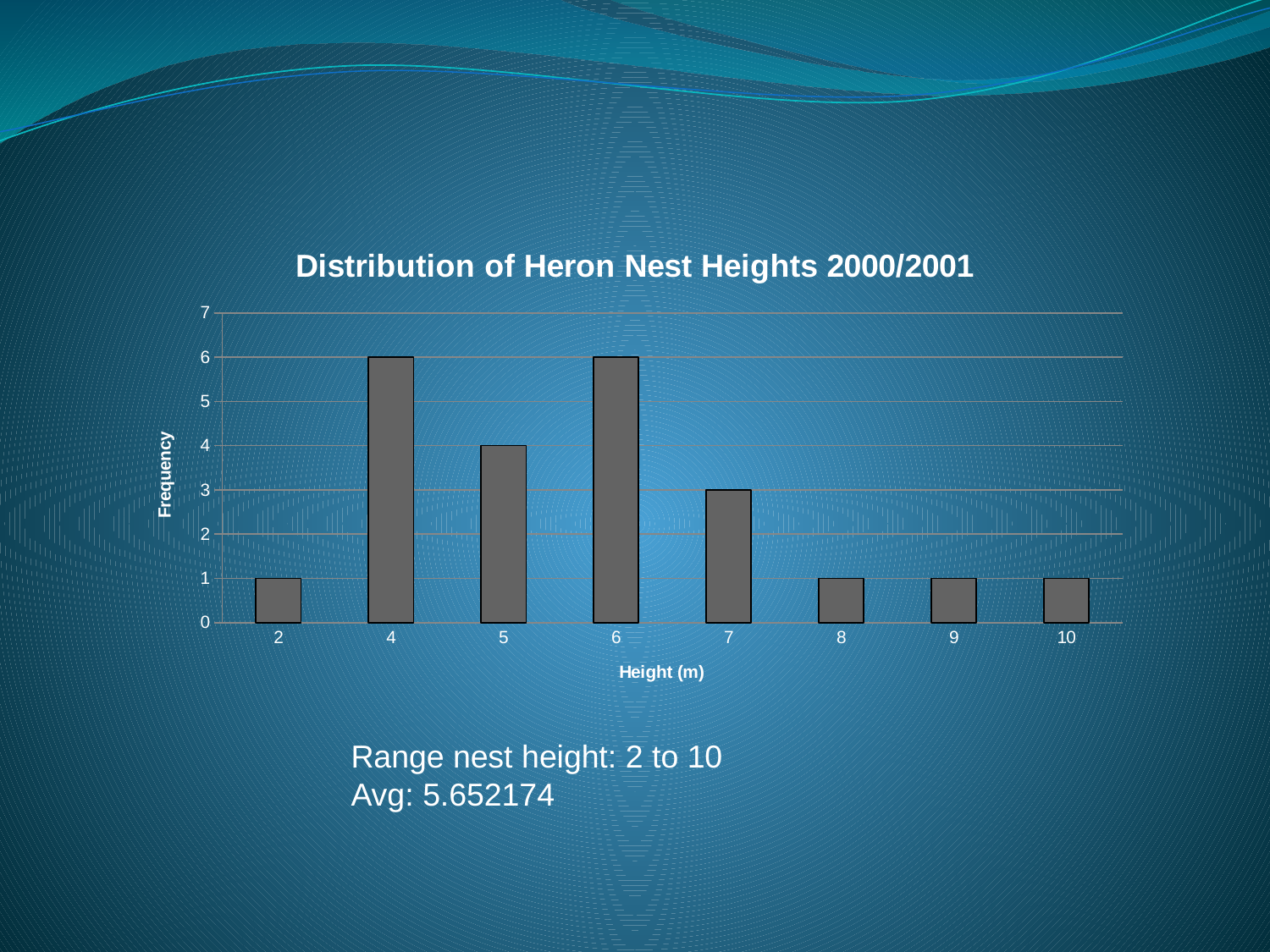
What is the frequency for a height of 7 m? 3 What is the frequency for a height of 4 m? 6 What is the frequency for a height of 5 m? 4 Which has a higher frequency, a height of 4 m or a height of 9 m? 4 m What is the frequency for a height of 2 m? 1 What is the title of the chart? Distribution of Heron Nest Heights 2000/2001 How many height categories are shown on the x axis? 8 What is the difference in frequency between heights of 6 m and 7 m? 3 What is the difference in frequency between heights of 5 m and 8 m? 3 Which has a higher frequency, a height of 5 m or a height of 7 m? 5 m What kind of chart is shown on the slide? Bar chart What is the label of the y axis? Frequency